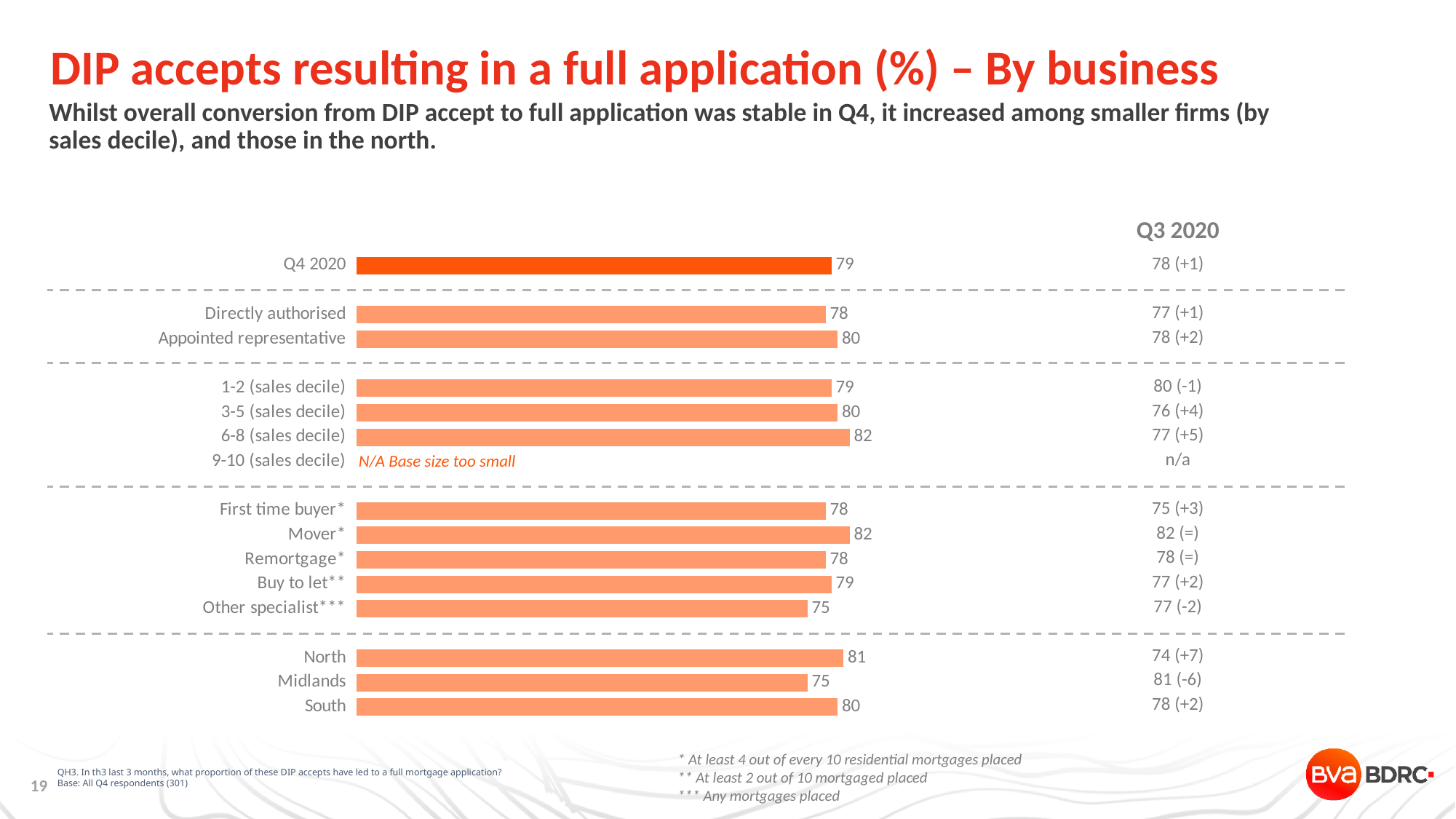
What is the value for 6-8 (sales decile)? 82 Among the three regions (North, Midlands, South), which has the lowest value? Midlands Which is larger, the value for Mover or the value for First time buyer? Mover What is the value for Other specialist? 75 How many regions are plotted in the bottom section of the chart? 3 What is the value for Q4 2020 overall? 79 Among the three regions (North, Midlands, South), which has the highest value? North What kind of chart is shown on the slide? Bar chart What is the value for Appointed representative? 80 What is the value for North? 81 What is the difference between the values for North and Midlands? 6 Which sales decile category has no bar plotted because the base size is too small? 9-10 (sales decile)